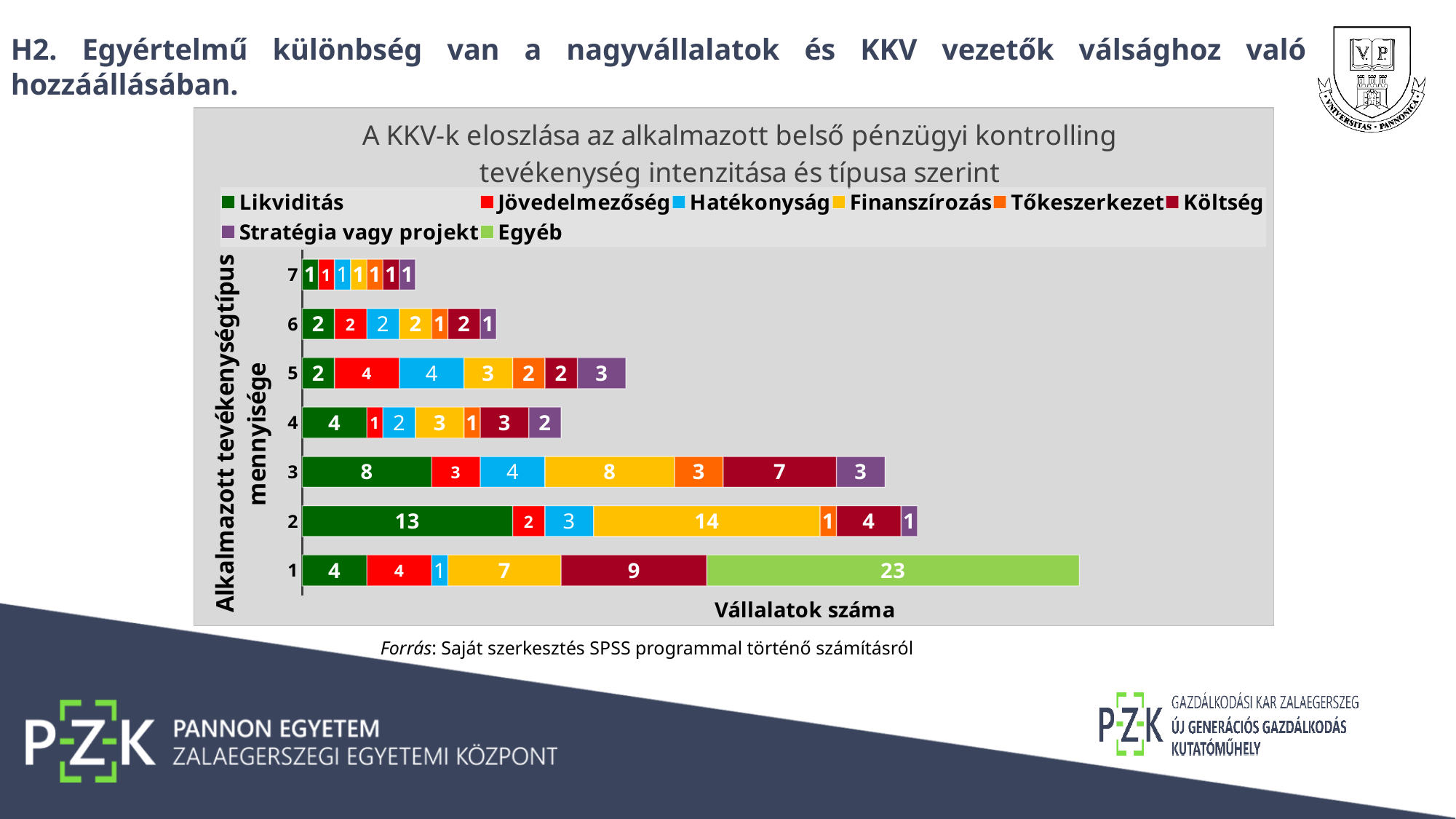
What is the Finanszírozás value for category 3? 8 What is the Költség value for category 1? 9 What is the Egyéb value for category 1? 23 What is the x-axis title of the chart? Vállalatok száma What is the difference between the Finanszírozás values for category 2 and category 3? 6 How many categories (activity-type counts) are shown on the y axis? 7 Which category has the highest Likviditás value? 2 What is the total of the stacked bar for category 7? 7 What is the total of the stacked bar for category 1? 48 How many series does the legend list? 8 What is the Likviditás value for category 2? 13 What kind of chart is shown on the slide? Stacked bar chart